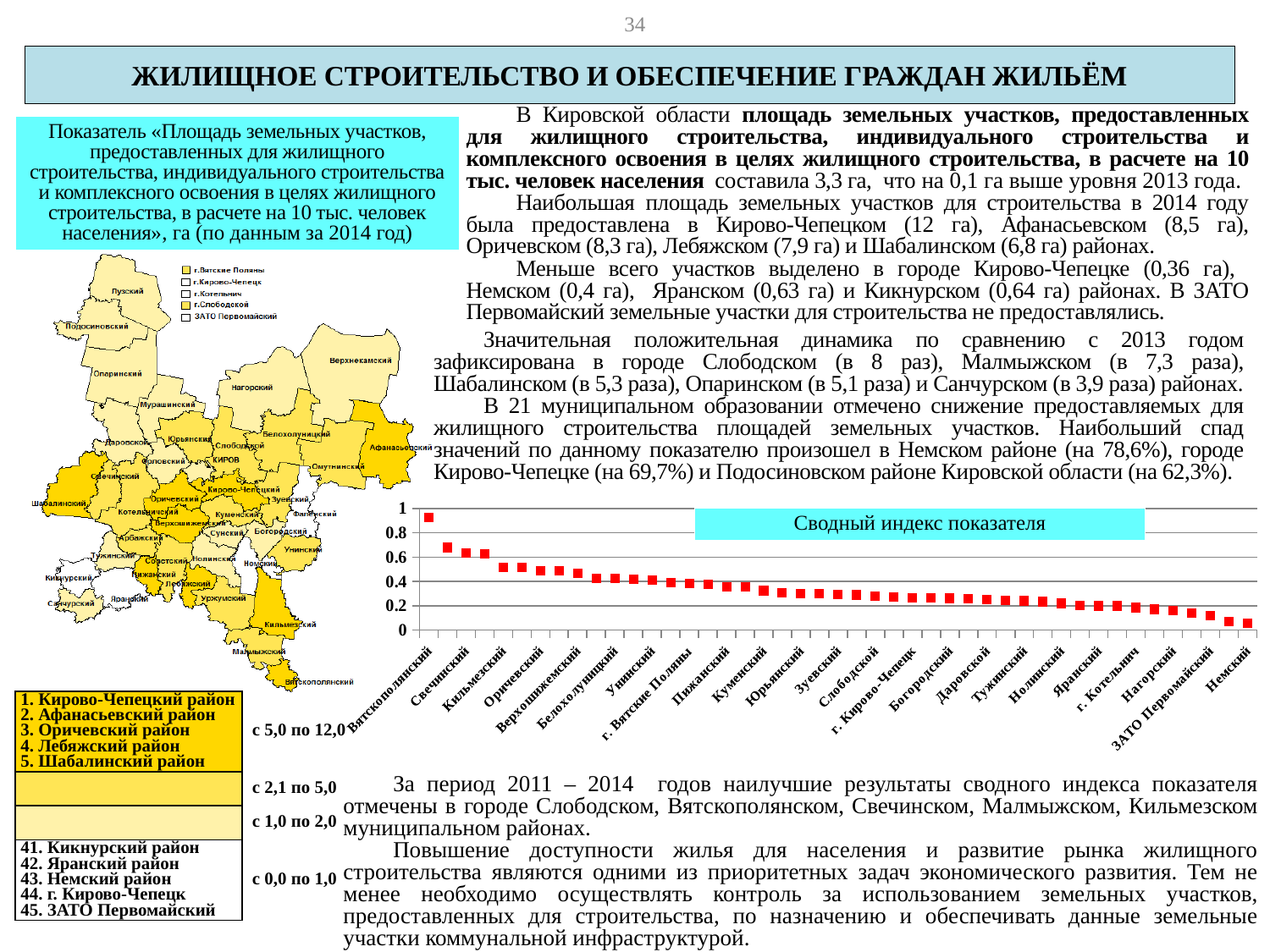
In the 'Сводный индекс показателя' chart, is the value for Оричевский greater or less than 0.4? greater In the 'Сводный индекс показателя' chart, do the values rise or fall from left to right along the x axis? fall In the 'Сводный индекс показателя' chart, is the value for Вятскополянский greater or less than 0.8? greater In the 'Сводный индекс показателя' chart, which labelled municipality has the lowest value? Немский In the 'Сводный индекс показателя' chart, is the value for Немский greater or less than 0.2? less What is the title of the chart on the slide? Сводный индекс показателя In the 'Сводный индекс показателя' chart, which has the larger value, Вятскополянский or г. Кирово-Чепецк? Вятскополянский In the 'Сводный индекс показателя' chart, which labelled municipality has the highest value? Вятскополянский What kind of chart is the 'Сводный индекс показателя' chart? scatter chart In the 'Сводный индекс показателя' chart, which has the larger value, Свечинский or Немский? Свечинский